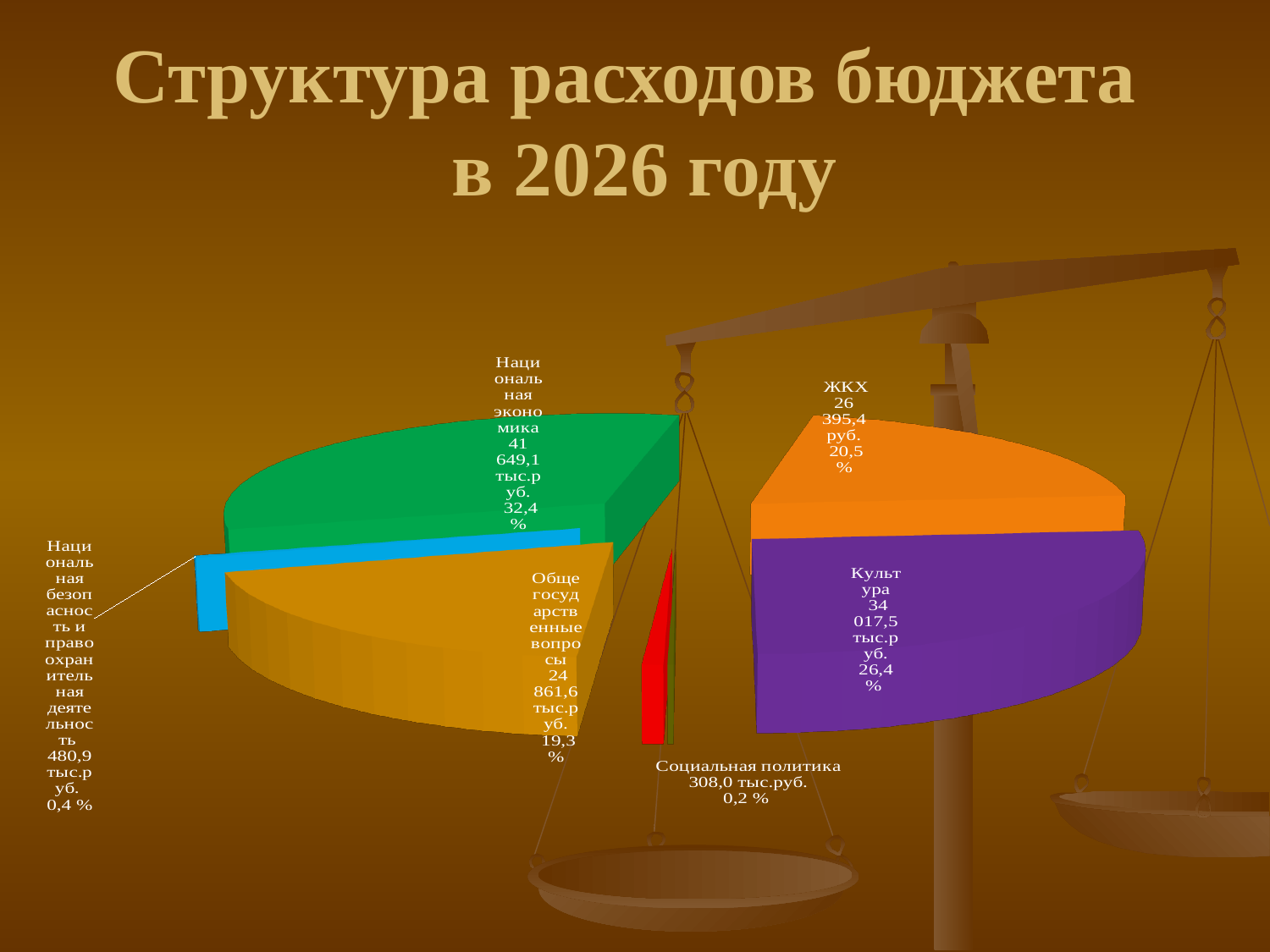
What is the value shown for Общегосударственные вопросы? 24 861,6 тыс.руб. What is the difference in percentage points between the shares of Национальная экономика and Общегосударственные вопросы? 13,1 What share of the pie does Национальная экономика have? 32,4 % What is the title of the slide's chart? Структура расходов бюджета в 2026 году How many slices does the pie chart have? 7 What is the value shown for Культура? 34 017,5 тыс.руб. What percentage is shown for ЖКХ? 20,5 % Which is larger, the share for Культура or the share for ЖКХ? Культура What is the value shown for Социальная политика? 308,0 тыс.руб. Which category has the largest share of the pie? Национальная экономика What kind of chart is shown on the slide? Pie chart Which category has the smallest share of the pie? Социальная политика